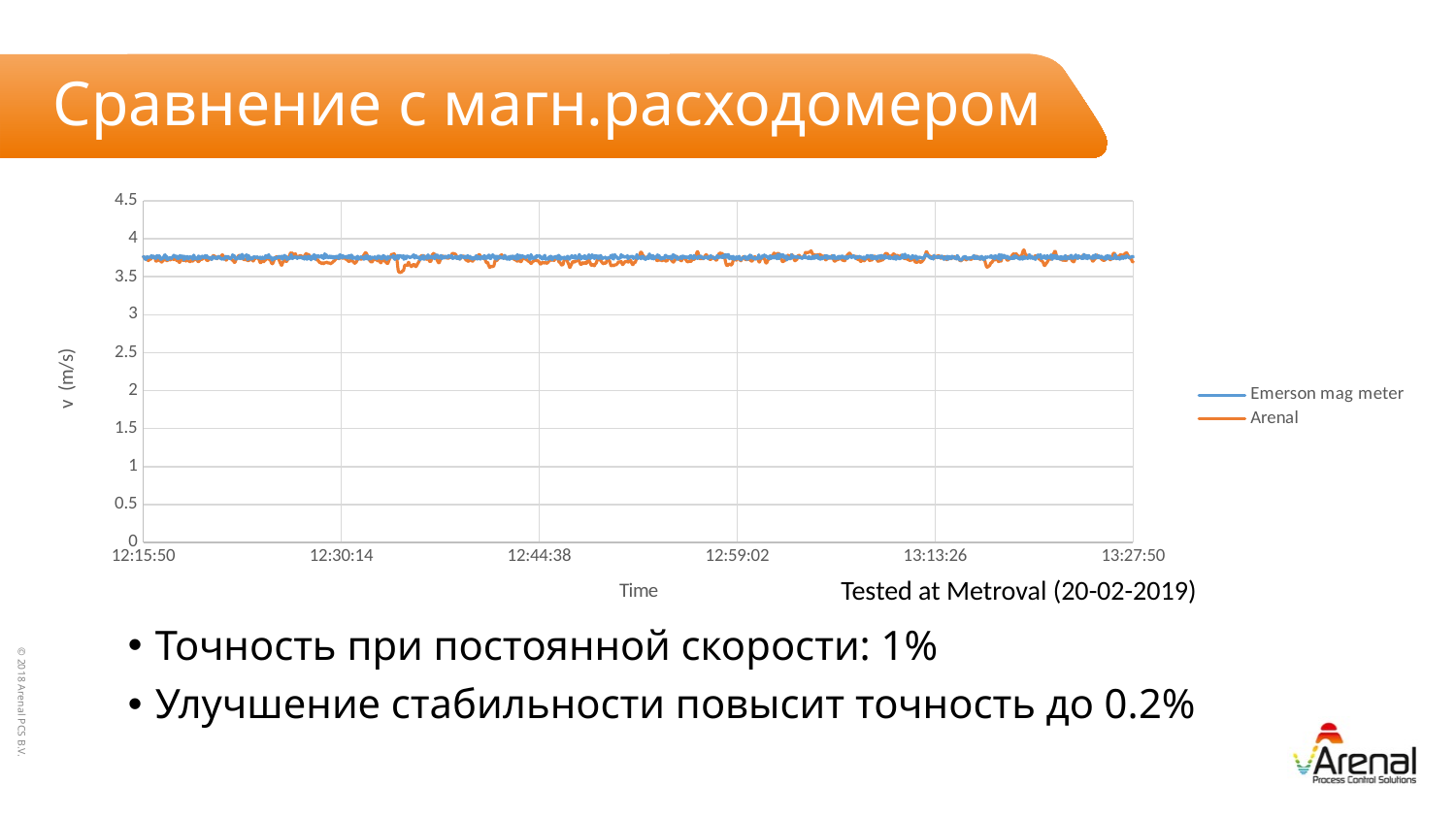
Which colour is used for the Arenal series in the chart? orange Is the value of the Arenal series greater or less than 4 m/s throughout the chart? less What kind of chart is shown on the slide? line chart What is the last time shown on the horizontal axis of the chart? 13:27:50 Is the value of the Arenal series greater or less than 3 m/s throughout the chart? greater How many series does the chart legend list? 2 Is the value of the Emerson mag meter series greater or less than 3.5 m/s throughout the chart? greater What is the label of the vertical axis of the chart? v (m/s) Do the plotted values rise, fall, or stay roughly constant along the time axis? stay roughly constant What is the maximum value shown on the vertical axis of the chart? 4.5 What is the first time shown on the horizontal axis of the chart? 12:15:50 What are the two series named in the chart legend? Emerson mag meter and Arenal